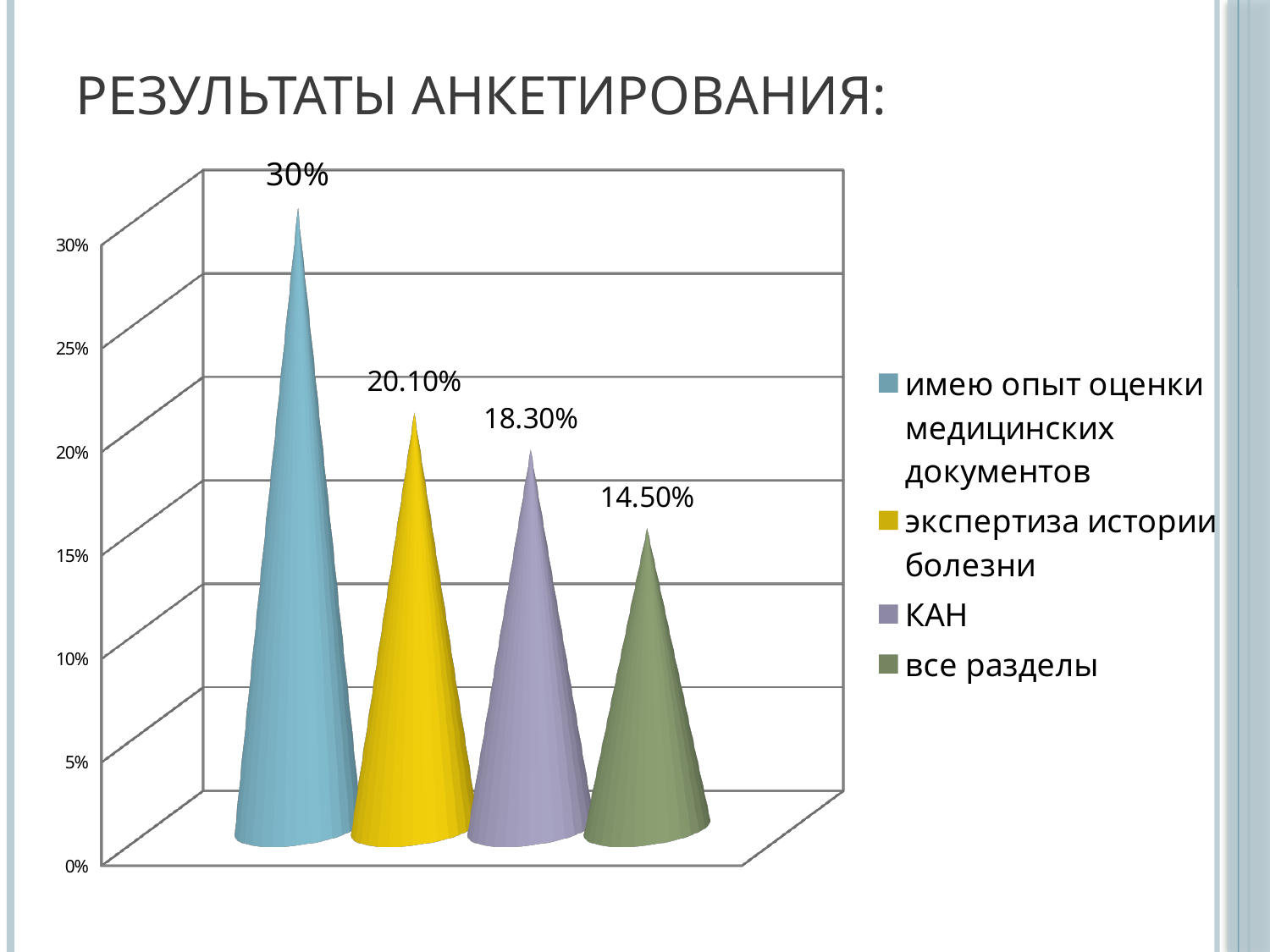
What is the difference between the values for 'экспертиза истории болезни' and 'КАН'? 1.80% How many series does the legend list? 4 What kind of chart is shown on the slide? bar chart Which category has the highest value? имею опыт оценки медицинских документов Which category has the lowest value? все разделы What is the value for 'имею опыт оценки медицинских документов'? 30% Which is larger, the value for 'КАН' or the value for 'все разделы'? КАН What is the title of the slide? РЕЗУЛЬТАТЫ АНКЕТИРОВАНИЯ: What is the value for 'все разделы'? 14.50% What is the value for 'КАН'? 18.30% What is the value for 'экспертиза истории болезни'? 20.10% What is the difference between the values for 'имею опыт оценки медицинских документов' and 'все разделы'? 15.50%